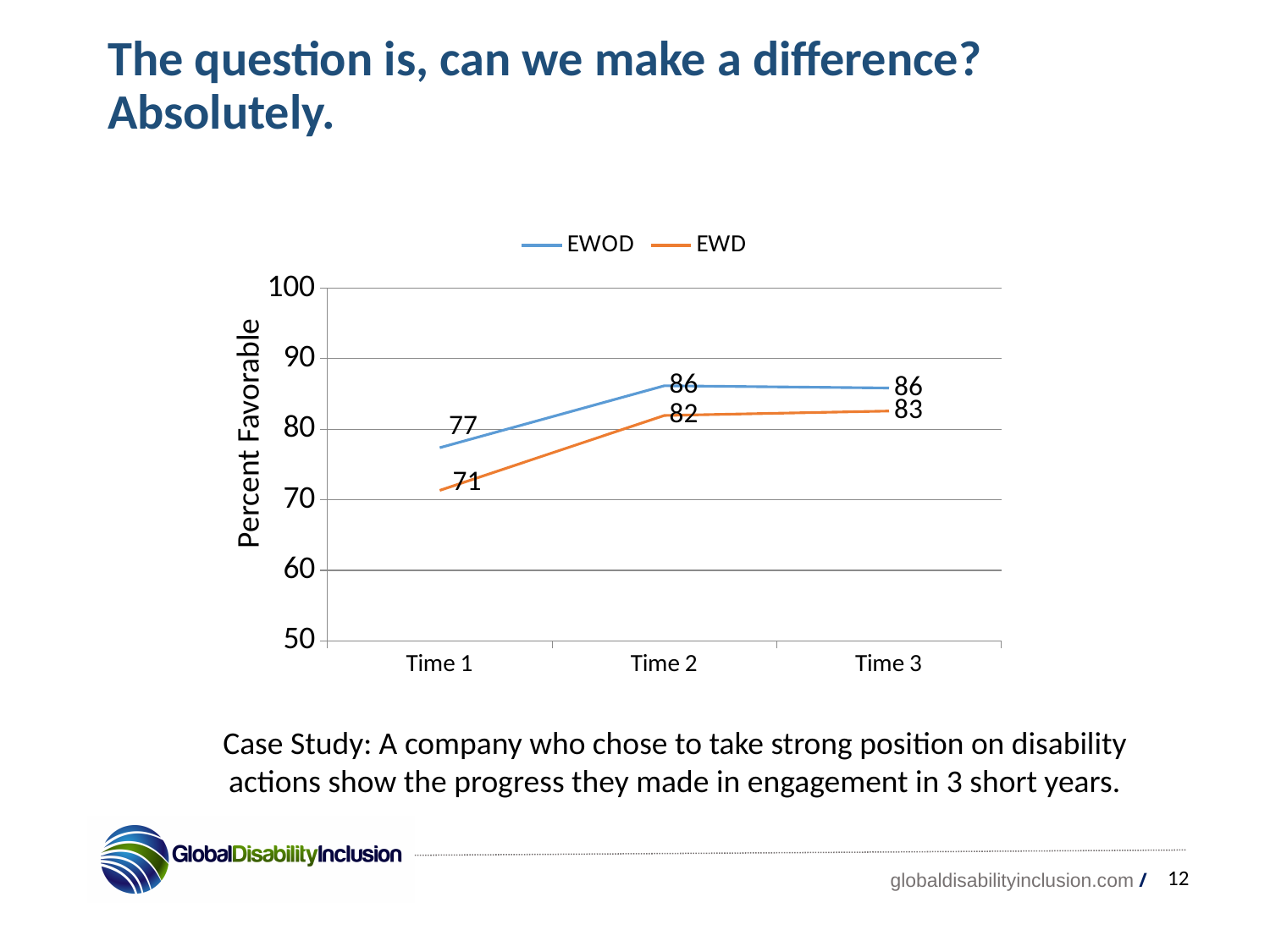
What is the EWD value at Time 2? 82 Which is larger at Time 2, the EWOD value or the EWD value? EWOD At which time point is the EWD value lowest? Time 1 How many series does the legend list? 2 By how much did the EWD value increase from Time 1 to Time 3? 12 What kind of chart is shown on the slide? line chart What is the difference between the EWOD and EWD values at Time 1? 6 What is the label of the y axis? Percent Favorable What is the EWOD value at Time 1? 77 Is the EWD value at Time 1 greater or less than 80? less How many time points are shown on the x axis? 3 What is the EWD value at Time 3? 83